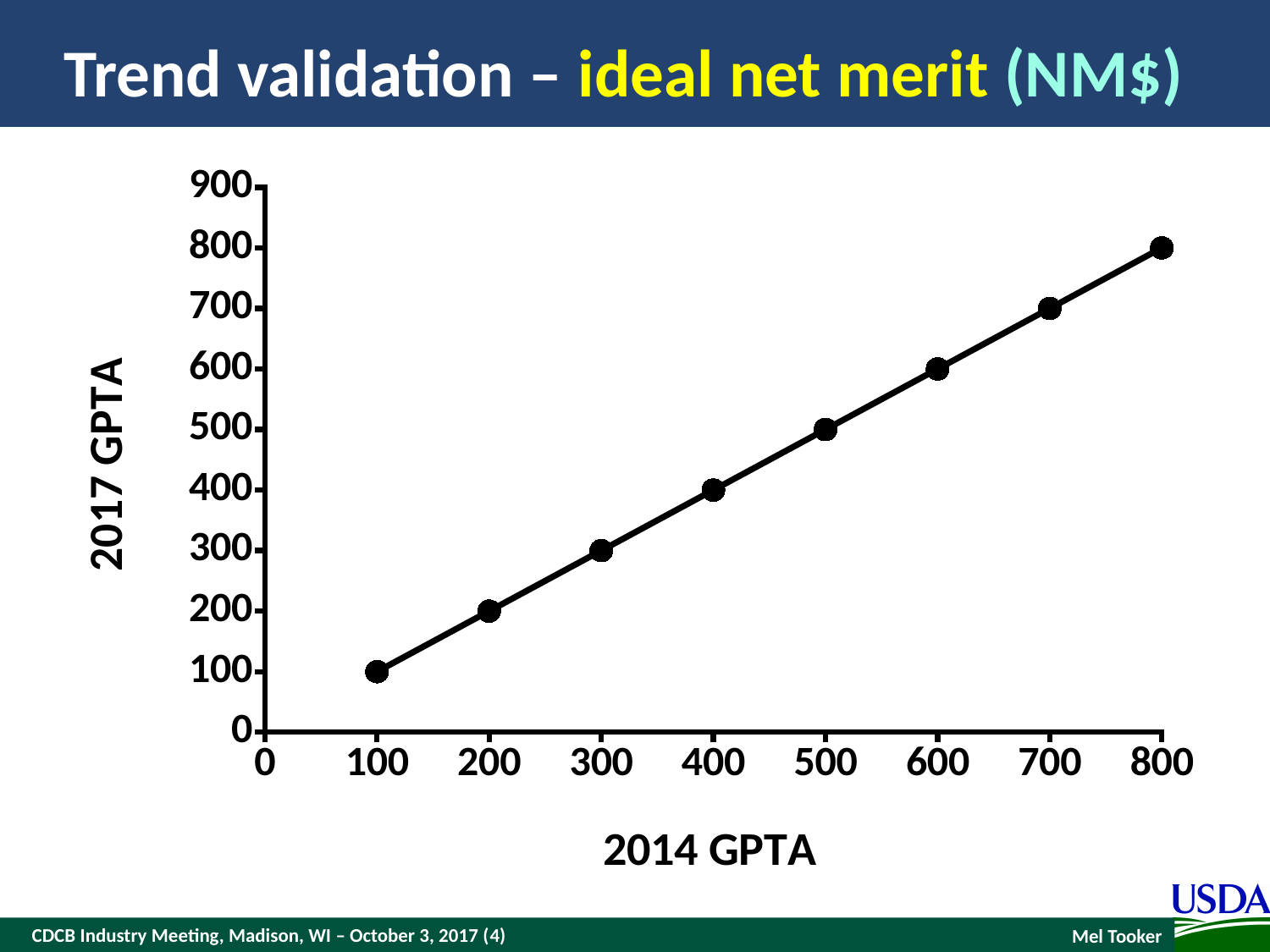
How many data points are plotted on the chart? 8 What kind of chart is shown on the slide? line chart What is the difference in 2017 GPTA between the points at 2014 GPTA 700 and 2014 GPTA 300? 400 Which 2014 GPTA value has the highest 2017 GPTA? 800 What is the label of the x axis? 2014 GPTA Which has a larger 2017 GPTA: the point at 2014 GPTA 600 or the point at 2014 GPTA 200? 2014 GPTA 600 What is the 2017 GPTA value when the 2014 GPTA is 800? 800 What is the 2017 GPTA value when the 2014 GPTA is 100? 100 What is the 2017 GPTA value when the 2014 GPTA is 400? 400 Is the 2017 GPTA value at 2014 GPTA 500 greater or less than 300? greater Which 2014 GPTA value has the lowest 2017 GPTA? 100 Do the 2017 GPTA values rise or fall as 2014 GPTA increases? rise